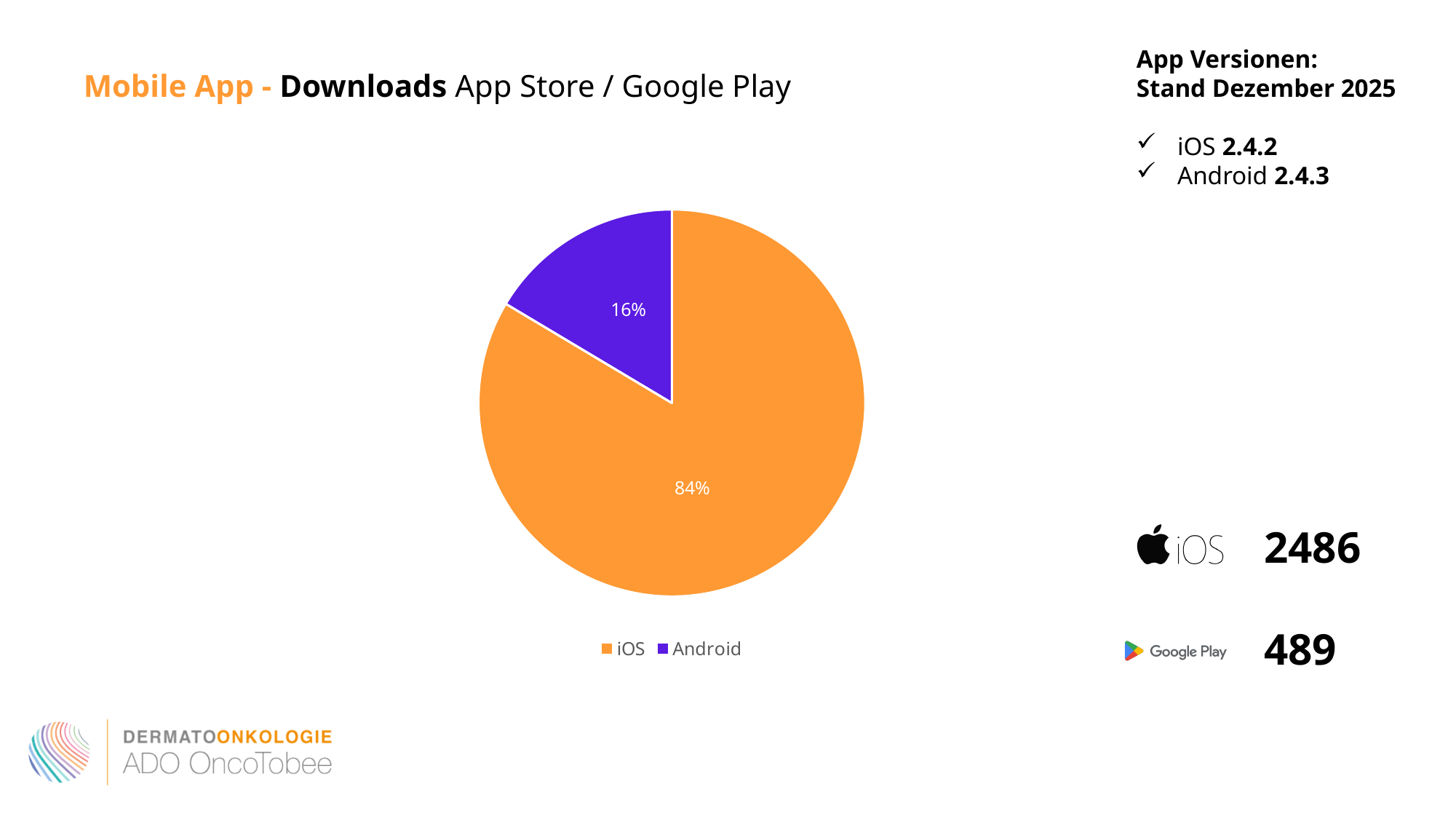
What colour is the Android slice in the pie chart? Purple What colour is the iOS slice in the pie chart? Orange What kind of chart is shown on the slide? Pie chart What share of the pie does iOS account for? 84% What share of the pie does Android account for? 16% What is the difference in percentage points between the iOS and Android slices? 68 percentage points Which slice of the pie is the largest? iOS How many entries does the legend list? 2 Which is larger, the iOS slice or the Android slice? iOS Which slice of the pie is the smallest? Android How many slices does the pie chart have? 2